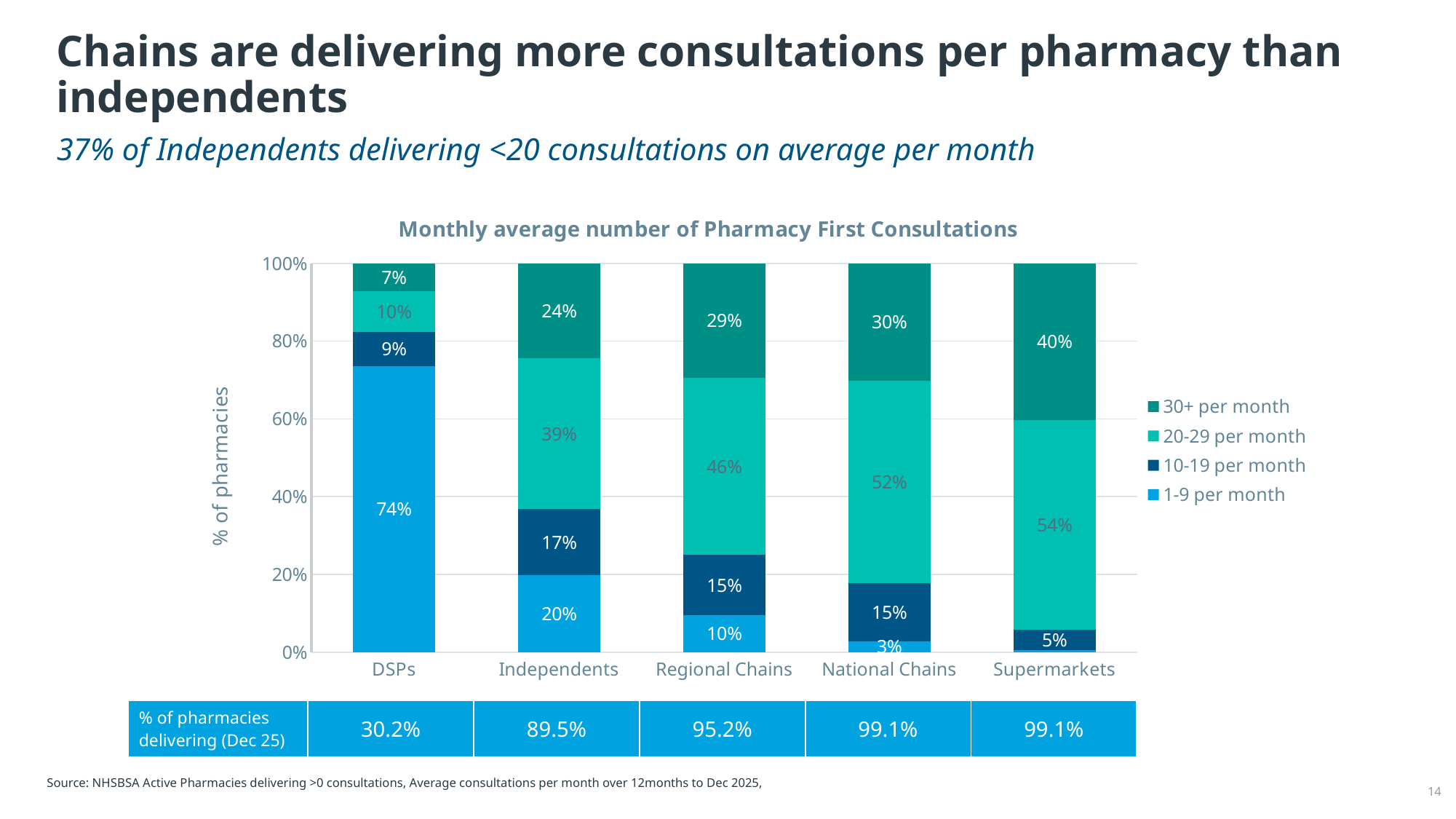
What is the label of the y axis? % of pharmacies How many series does the legend list? 4 What percentage of DSPs deliver 1-9 consultations per month? 74% What percentage of Supermarkets deliver 30+ consultations per month? 40% Which category has the highest share of pharmacies delivering 30+ consultations per month? Supermarkets What kind of chart is shown? Stacked bar chart What percentage of Independents deliver 10-19 consultations per month? 17% What is the difference between the 20-29 per month share for Supermarkets and for Independents? 15% What is the title of the chart? Monthly average number of Pharmacy First Consultations Which is larger: the 30+ per month share for Regional Chains or for Independents? Regional Chains How many categories are shown on the x axis? 5